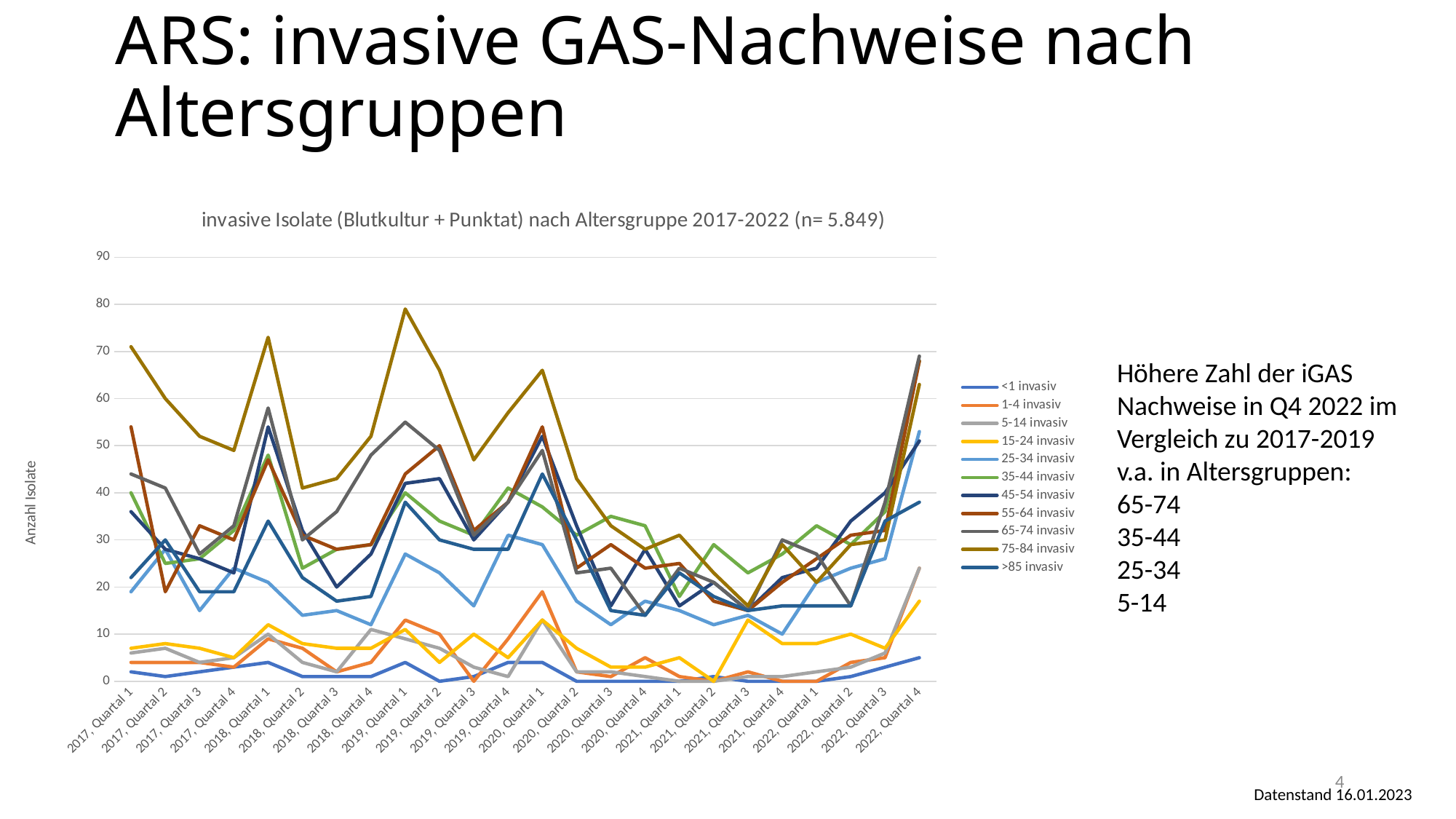
What is the label of the y axis of the chart? Anzahl Isolate What is the title of the chart? invasive Isolate (Blutkultur + Punktat) nach Altersgruppe 2017-2022 (n= 5.849) Does the 65-74 invasiv series rise or fall from 2022, Quartal 1 to 2022, Quartal 4? rise Is the value for 25-34 invasiv at 2022, Quartal 4 greater or less than 40? greater At 2022, Quartal 4, which is larger: 65-74 invasiv or <1 invasiv? 65-74 invasiv How many quarters are plotted along the x axis of the chart? 24 Which series reaches the highest value anywhere in the chart? 75-84 invasiv Which series has the highest value at 2017, Quartal 1? 75-84 invasiv Is the value for <1 invasiv at 2022, Quartal 4 greater or less than 10? less What kind of chart is shown on the slide? line chart How many series does the legend of the chart list? 11 Is the value for 75-84 invasiv at 2019, Quartal 1 greater or less than 70? greater